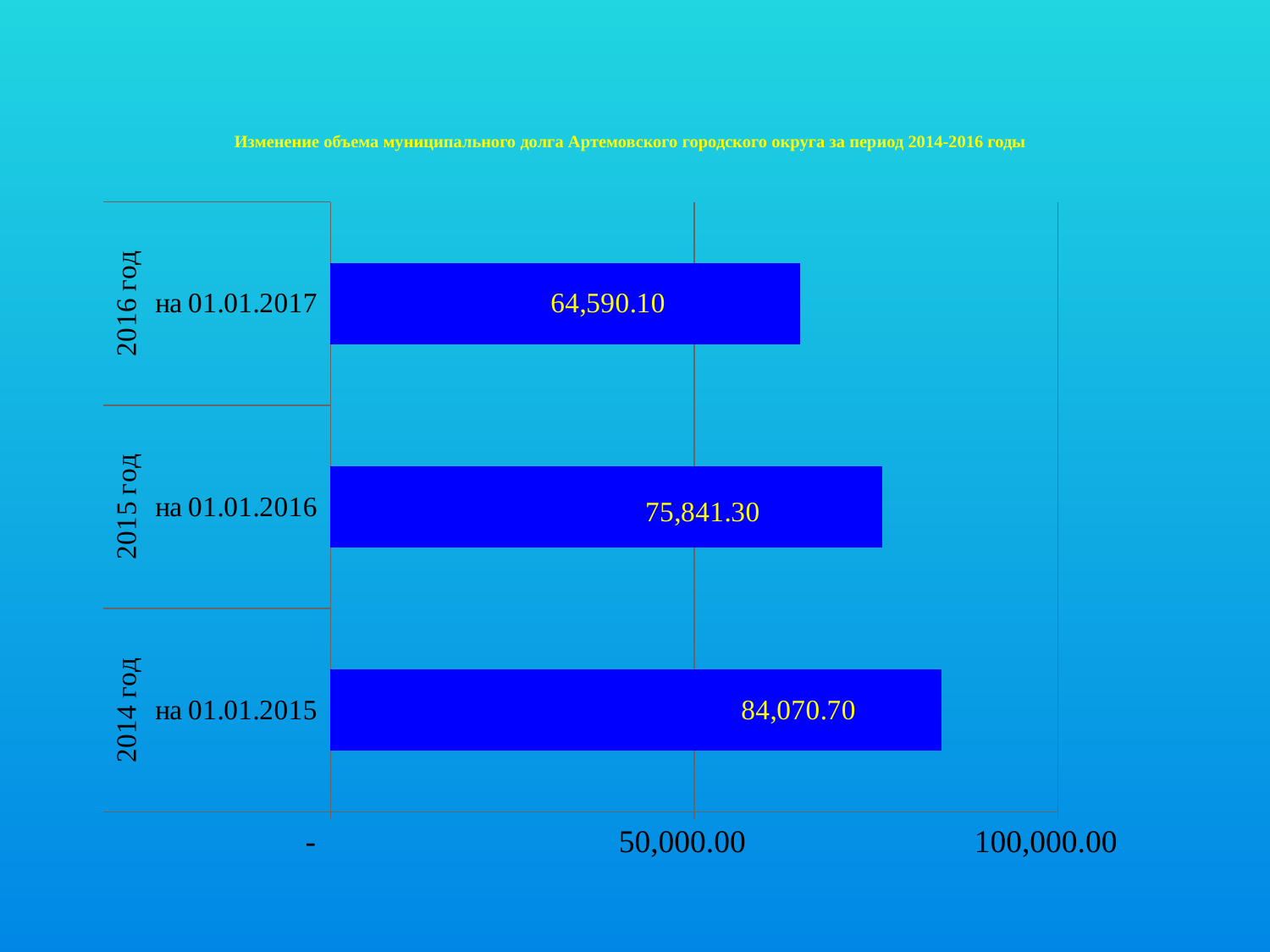
What is the difference between the values for "на 01.01.2015" and "на 01.01.2016"? 8,229.40 What is the value for "на 01.01.2017"? 64,590.10 How many bars are shown in the chart? 3 What is the difference between the values for "на 01.01.2016" and "на 01.01.2017"? 11,251.20 What kind of chart is shown on the slide? bar chart Which category has the lowest value? на 01.01.2017 Does the municipal debt rise or fall from 01.01.2015 to 01.01.2017? fall What is the value for "на 01.01.2015"? 84,070.70 What is the value for "на 01.01.2016"? 75,841.30 Which is larger, the value for "на 01.01.2016" or the value for "на 01.01.2017"? на 01.01.2016 Is the value for "на 01.01.2015" greater or less than 50,000.00? greater Which category has the highest value? на 01.01.2015